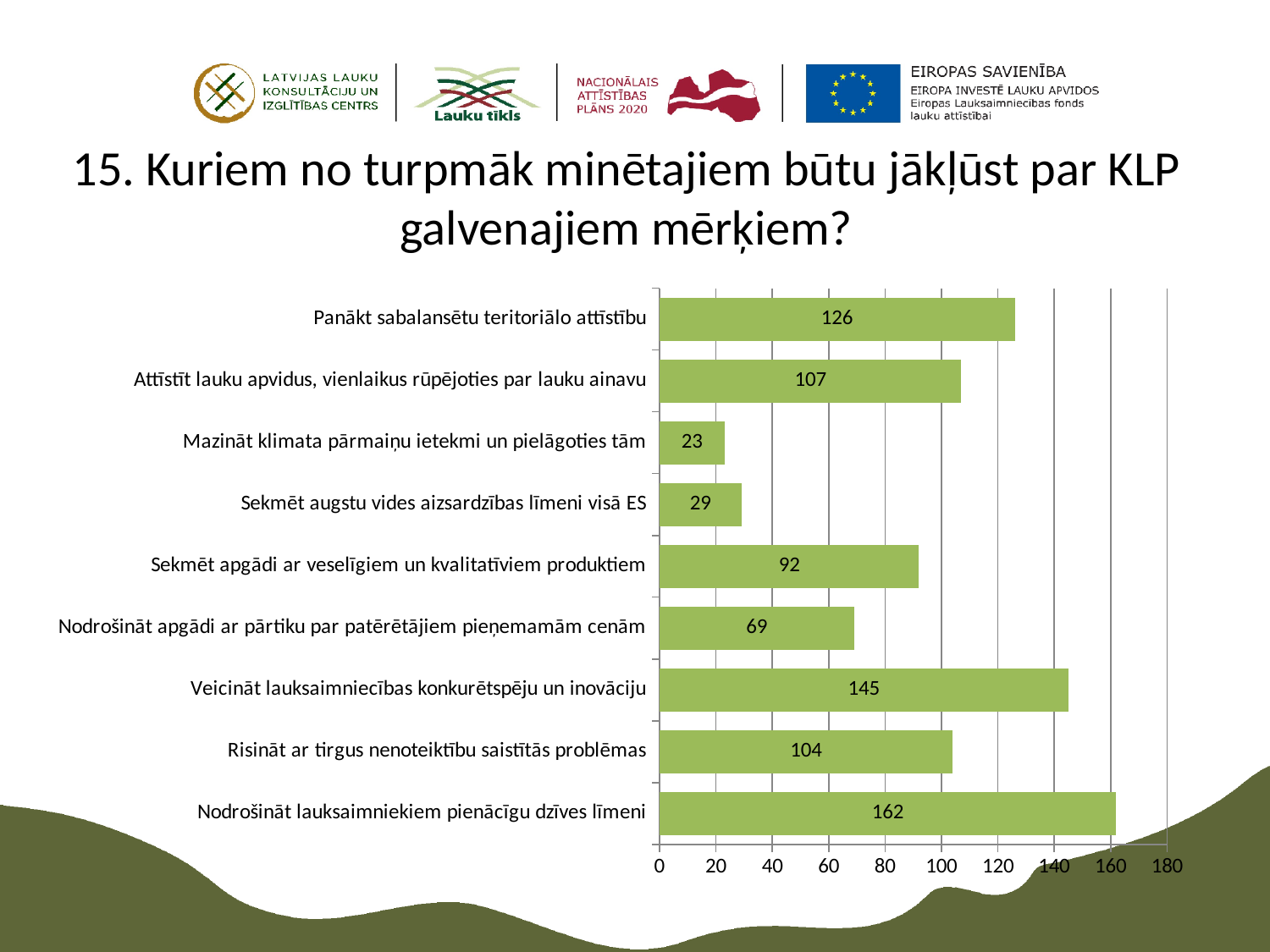
What kind of chart is shown on the slide? bar chart Which is larger: the value for "Panākt sabalansētu teritoriālo attīstību" or for "Attīstīt lauku apvidus, vienlaikus rūpējoties par lauku ainavu"? Panākt sabalansētu teritoriālo attīstību What is the value for "Sekmēt apgādi ar veselīgiem un kvalitatīviem produktiem"? 92 Which category has the lowest value? Mazināt klimata pārmaiņu ietekmi un pielāgoties tām How many categories are shown in the chart? 9 What is the value for "Nodrošināt lauksaimniekiem pienācīgu dzīves līmeni"? 162 What is the value for "Mazināt klimata pārmaiņu ietekmi un pielāgoties tām"? 23 What is the difference between the values for "Sekmēt augstu vides aizsardzības līmeni visā ES" and "Mazināt klimata pārmaiņu ietekmi un pielāgoties tām"? 6 Which category has the highest value? Nodrošināt lauksaimniekiem pienācīgu dzīves līmeni Is the value for "Nodrošināt apgādi ar pārtiku par patērētājiem pieņemamām cenām" greater or less than 80? less What is the difference between the values for "Veicināt lauksaimniecības konkurētspēju un inovāciju" and "Risināt ar tirgus nenoteiktību saistītās problēmas"? 41 What is the maximum value shown on the horizontal axis? 180